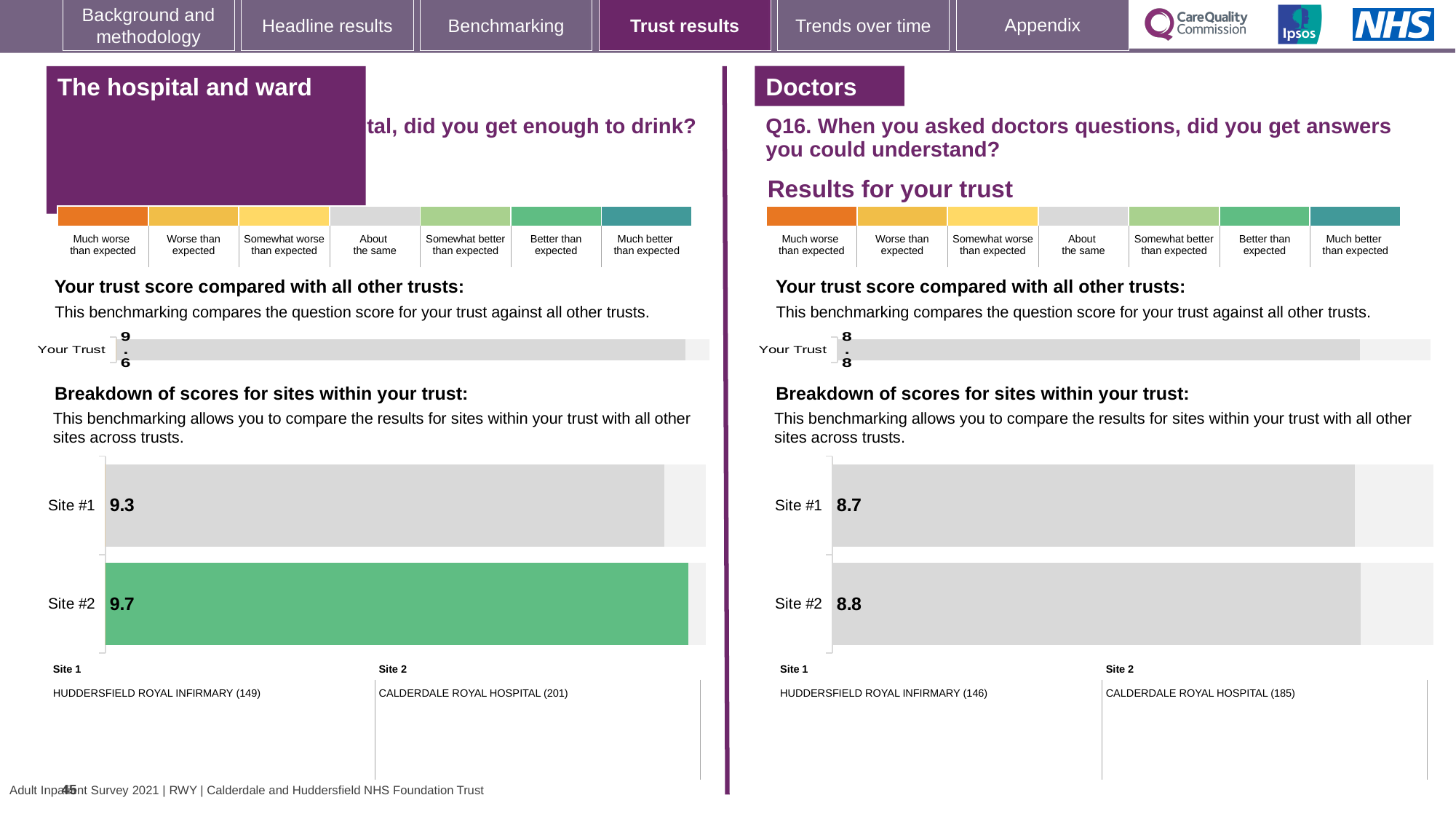
On the left-hand site breakdown chart, which site has the higher score? Site #2 On the left-hand 'Breakdown of scores for sites within your trust' chart, what is the score for Site #1? 9.3 How many sites are shown on the left-hand site breakdown chart? 2 On the right-hand (Doctors, Q16) site breakdown chart, what is the difference between the Site #2 and Site #1 scores? 0.1 What type of chart is used for the site breakdown on the right-hand (Doctors, Q16) side? Bar chart On the left-hand site breakdown chart, what colour is the bar for Site #2? Green On the left-hand 'Breakdown of scores for sites within your trust' chart, what is the score for Site #2? 9.7 On the right-hand (Doctors, Q16) 'Breakdown of scores for sites within your trust' chart, what is the score for Site #1? 8.7 On the left-hand site breakdown chart, what is the difference between the Site #2 and Site #1 scores? 0.4 On the right-hand (Doctors, Q16) 'Breakdown of scores for sites within your trust' chart, what is the score for Site #2? 8.8 On the left-hand 'Your trust score compared with all other trusts' chart, what is the score shown for Your Trust? 9.6 On the right-hand (Doctors, Q16) 'Your trust score compared with all other trusts' chart, what is the score shown for Your Trust? 8.8